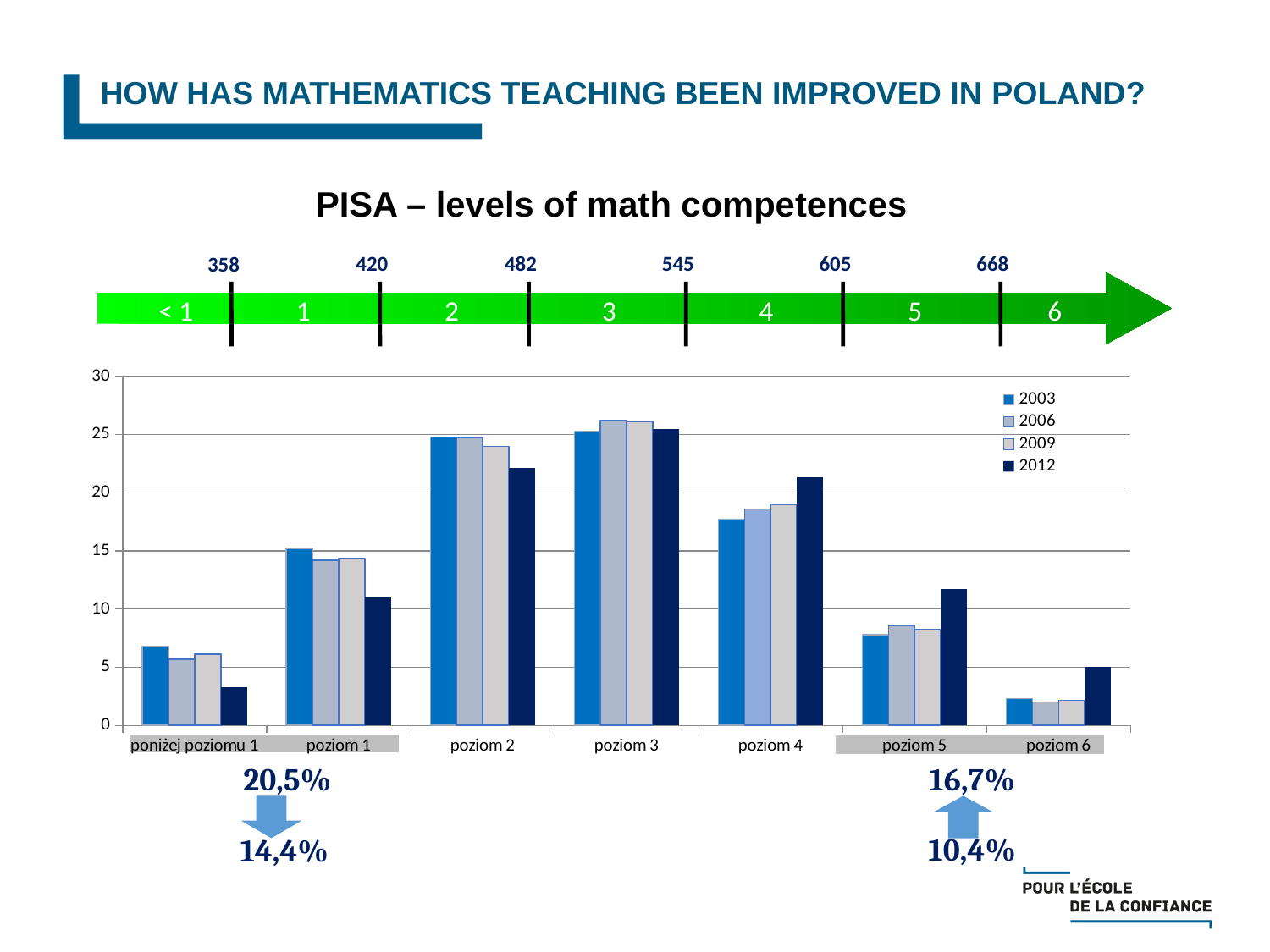
Is the value for 2006 at poziom 3 greater or less than 25? greater Is the value for 2012 at poziom 4 greater or less than 20? greater How many categories (levels) are shown on the x axis of the chart? 7 What kind of chart is shown on the slide? bar chart At poziom 4, do the values rise or fall from 2003 to 2012? rise At poziom 2, which is larger: the 2003 value or the 2012 value? 2003 Which years are listed in the chart's legend? 2003, 2006, 2009, 2012 For the 2003 series, which category has the lowest bar? poziom 6 What is the title of the chart? PISA – levels of math competences How many series does the chart's legend list? 4 For the 2012 series, which category has the highest bar? poziom 3 Is the value for 2012 at poniżej poziomu 1 greater or less than 5? less